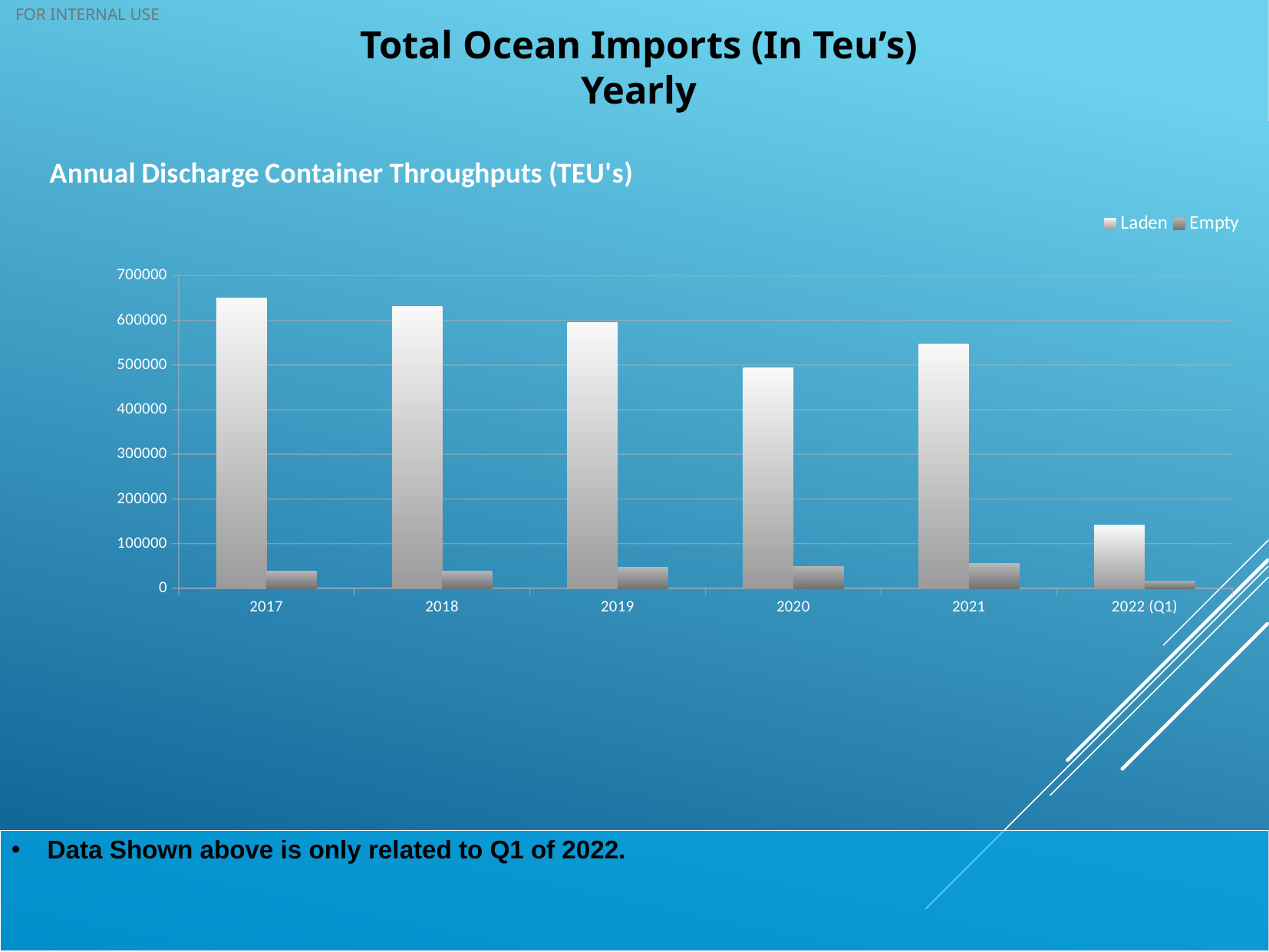
Do the Laden values rise or fall from 2017 to 2020? Fall Which is larger, the Laden value for 2018 or for 2020? 2018 What kind of chart is shown on the slide? Bar chart Which category has the lowest Laden value? 2022 (Q1) Is the Laden value for 2022 (Q1) greater or less than 100000? greater How many series does the legend list? 2 Which year has the highest Laden value? 2017 Is the Laden value for 2017 greater or less than 600000? greater What is the title of the chart? Annual Discharge Container Throughputs (TEU's) How many categories are shown on the x axis? 6 Is the Laden value for 2021 greater or less than 500000? greater Which category has the lowest Empty value? 2022 (Q1)